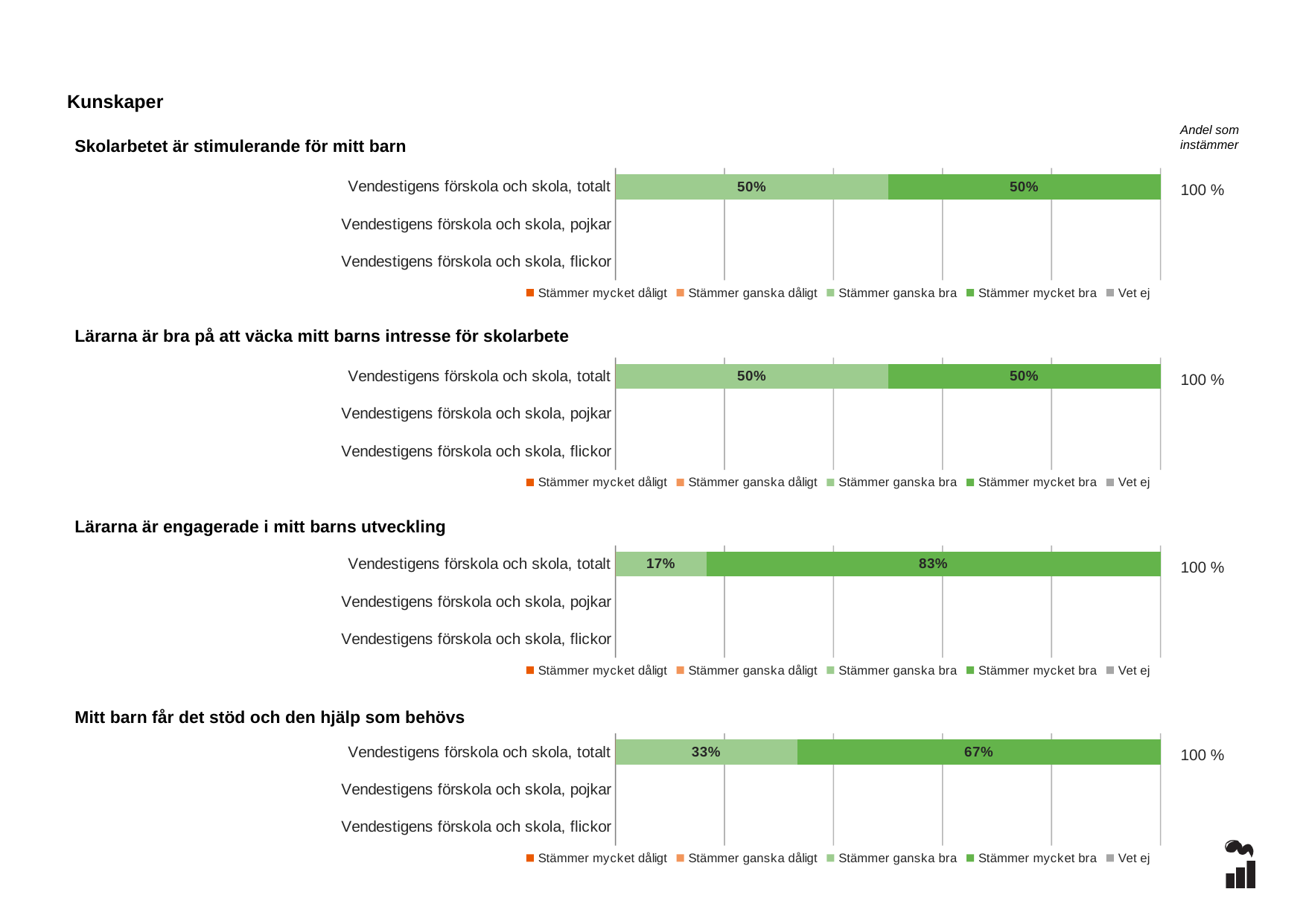
In the chart 'Mitt barn får det stöd och den hjälp som behövs', what is the value for 'Stämmer mycket bra' for Vendestigens förskola och skola, totalt? 67% What is the last legend entry in the chart 'Lärarna är bra på att väcka mitt barns intresse för skolarbete'? Vet ej In the chart 'Lärarna är engagerade i mitt barns utveckling', what is the value for 'Stämmer ganska bra' for Vendestigens förskola och skola, totalt? 17% In the chart 'Mitt barn får det stöd och den hjälp som behövs', which is larger for Vendestigens förskola och skola, totalt: 'Stämmer ganska bra' or 'Stämmer mycket bra'? Stämmer mycket bra How many series does the legend list in the chart 'Skolarbetet är stimulerande för mitt barn'? 5 In the chart 'Lärarna är bra på att väcka mitt barns intresse för skolarbete', what is the total of the stacked bar for Vendestigens förskola och skola, totalt? 100% What kind of chart is 'Mitt barn får det stöd och den hjälp som behövs'? Stacked bar chart In the chart 'Skolarbetet är stimulerande för mitt barn', what is the value for 'Stämmer mycket bra' for Vendestigens förskola och skola, totalt? 50% In the chart 'Lärarna är engagerade i mitt barns utveckling', what is the value for 'Stämmer mycket bra' for Vendestigens förskola och skola, totalt? 83% In the chart 'Mitt barn får det stöd och den hjälp som behövs', what is the value for 'Stämmer ganska bra' for Vendestigens förskola och skola, totalt? 33% How many categories are shown on the y axis of the chart 'Lärarna är engagerade i mitt barns utveckling'? 3 In the chart 'Lärarna är engagerade i mitt barns utveckling', what is the difference between the 'Stämmer mycket bra' and 'Stämmer ganska bra' values for Vendestigens förskola och skola, totalt? 66%